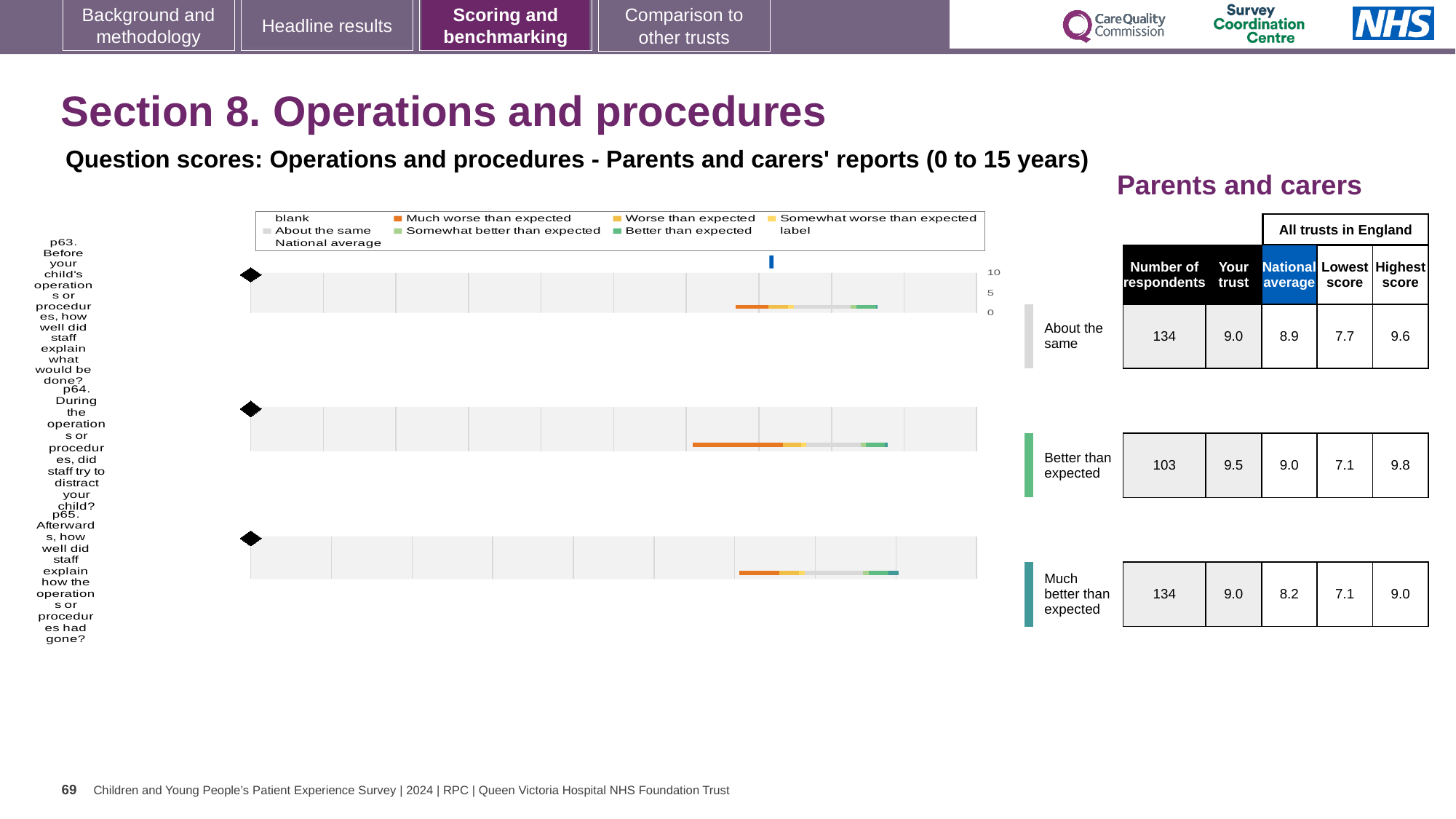
For the p64 chart, how many respondents are there? 103 What benchmark category label is shown for the p63 chart? About the same Which of the three questions (p63, p64, p65) has the highest 'Your trust' score? p64 Which of the three questions (p63, p64, p65) has the lowest national average? p65 For the p63 chart (Before your child's operations or procedures, how well did staff explain what would be done?), what is the 'Your trust' score? 9.0 For the p65 chart (Afterwards, how well did staff explain how the operations or procedures had gone?), what is the national average? 8.2 For the p64 chart (During the operations or procedures, did staff try to distract your child?), what is the 'Your trust' score? 9.5 For the p65 chart, which is larger: the 'Your trust' score or the national average? Your trust What kind of chart is used for each question (p63, p64, p65) on this slide? bar chart How many question charts (p63, p64, p65) are shown on the slide? 3 What benchmark category label is shown for the p65 chart? Much better than expected For the p64 chart, what is the difference between the 'Your trust' score and the national average? 0.5